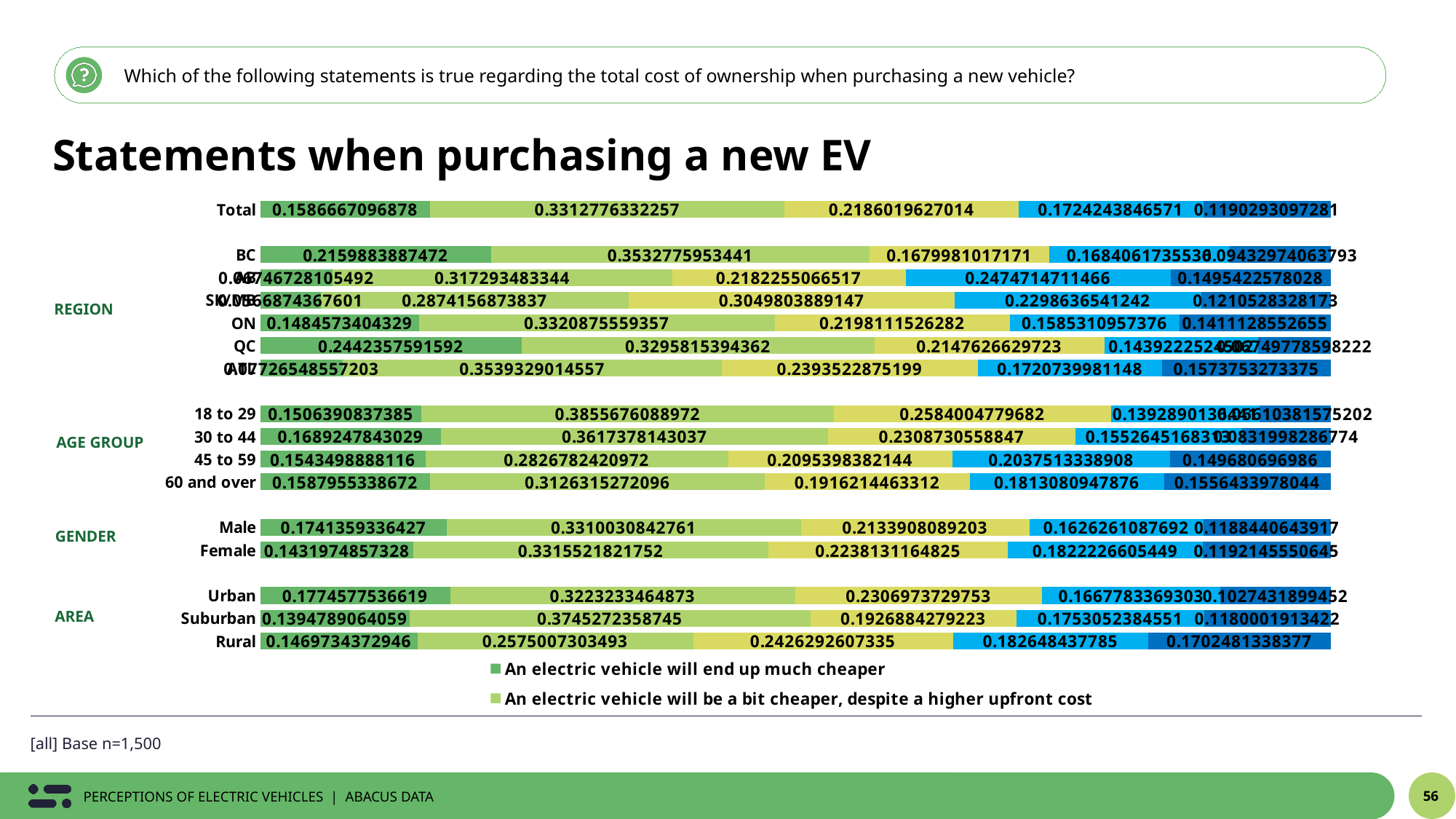
What is the value for QC in the "An electric vehicle will end up much cheaper" series? 0.2442357591592 What is the difference between Male and Female for "An electric vehicle will end up much cheaper"? 0.0309384479099 Which is larger for "An electric vehicle will end up much cheaper": Male or Female? Male Among the age groups, which has the lowest value for "An electric vehicle will be a bit cheaper, despite a higher upfront cost"? 45 to 59 What is the title of the chart on the slide? Statements when purchasing a new EV What is the value for Female in the "An electric vehicle will end up much cheaper" series? 0.1431974857328 What is the value for Rural in the "An electric vehicle will be a bit cheaper, despite a higher upfront cost" series? 0.2575007303493 What kind of chart is shown on the slide? Stacked bar chart How many categories are shown under the AREA group? 3 What is the value for 18 to 29 in the "An electric vehicle will be a bit cheaper, despite a higher upfront cost" series? 0.3855676088972 Among the age groups, which has the highest value for "An electric vehicle will end up much cheaper"? 30 to 44 Which is larger for "An electric vehicle will be a bit cheaper, despite a higher upfront cost": Suburban or Rural? Suburban